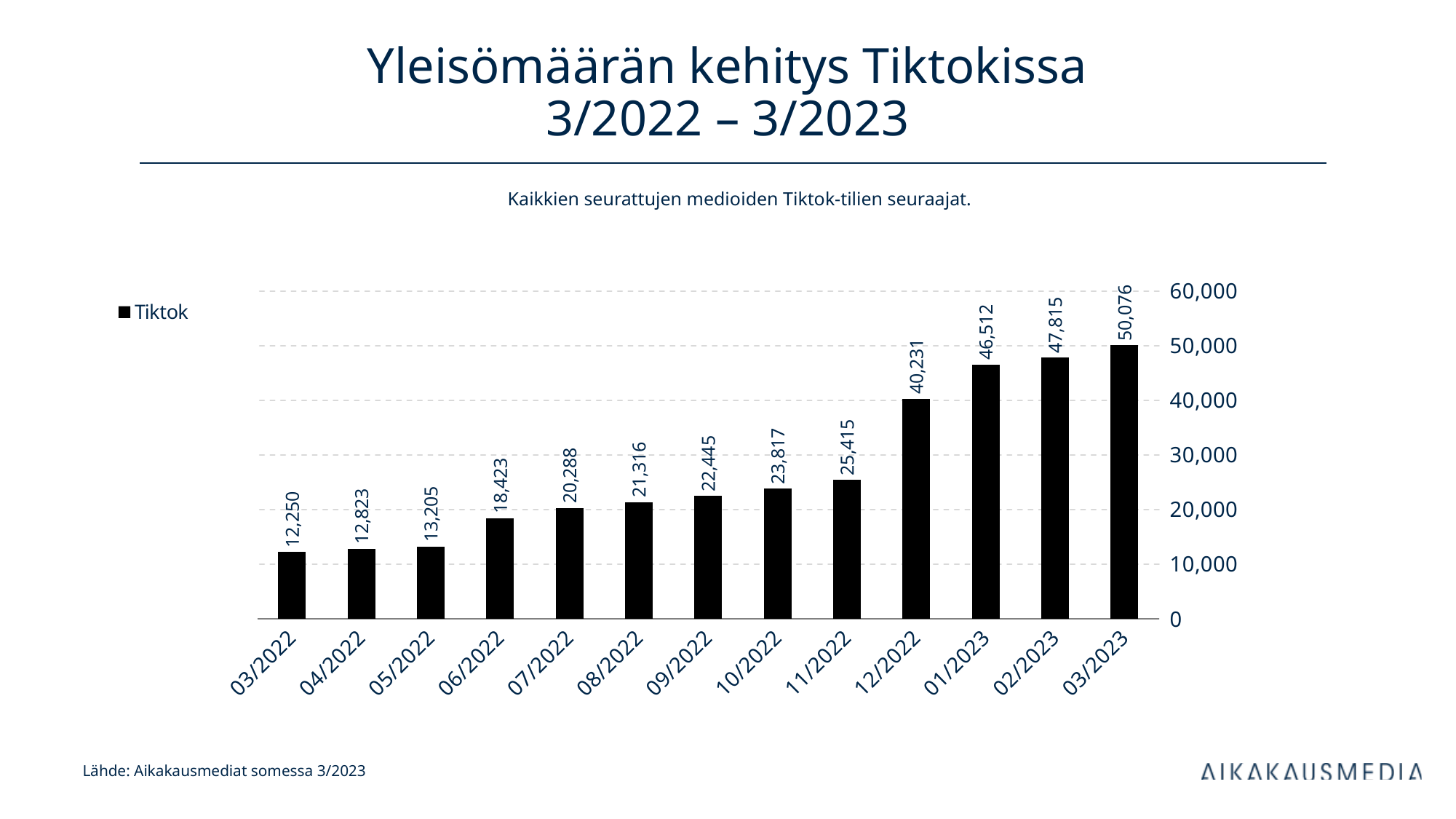
Which is larger, the value for 08/2022 or the value for 10/2022? 10/2022 What is the value for 03/2023? 50,076 Do the values rise or fall from 03/2022 to 03/2023? rise Which month has the lowest value? 03/2022 What is the difference between the values for 03/2023 and 03/2022? 37,826 What is the difference between the values for 12/2022 and 11/2022? 14,816 Is the value for 01/2023 greater or less than 40,000? greater Which month has the highest value? 03/2023 How many months are shown on the x axis? 13 What kind of chart is shown on the slide? bar chart What is the value for 12/2022? 40,231 What is the value for 03/2022? 12,250